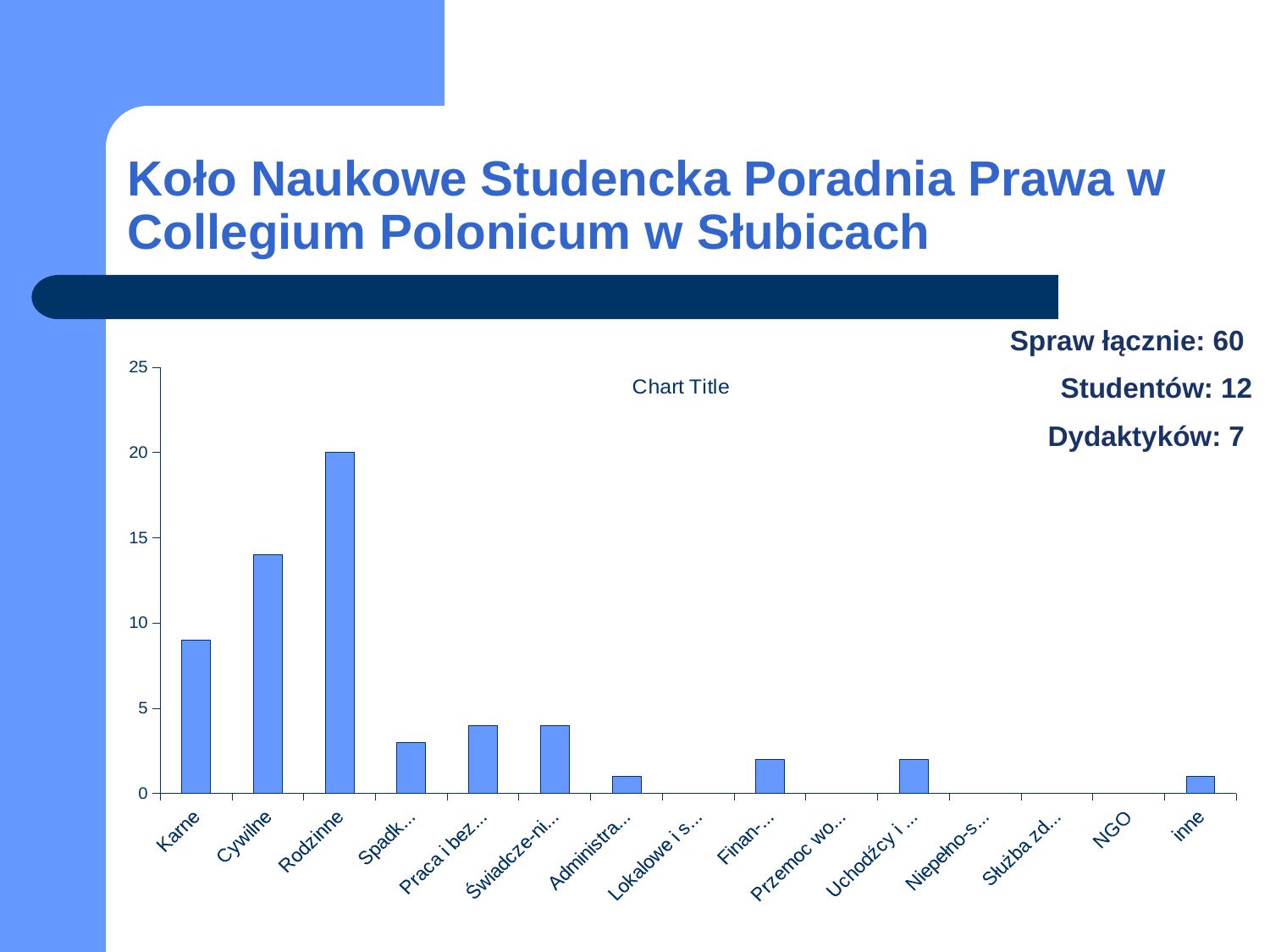
Is the value for Rodzinne greater or less than 15? greater What kind of chart is shown on the slide? bar chart Which category has the highest bar in the chart? Rodzinne What is the highest value shown on the chart's vertical axis? 25 Is the value for Karne greater or less than 10? less Is the value for Spadk... greater or less than 5? less What is the title shown on the chart? Chart Title Which is larger, the value for Karne or the value for Spadk...? Karne Which is larger, the value for Cywilne or the value for Karne? Cywilne What is the value for Rodzinne in the chart? 20 How many categories are shown on the x axis of the chart? 15